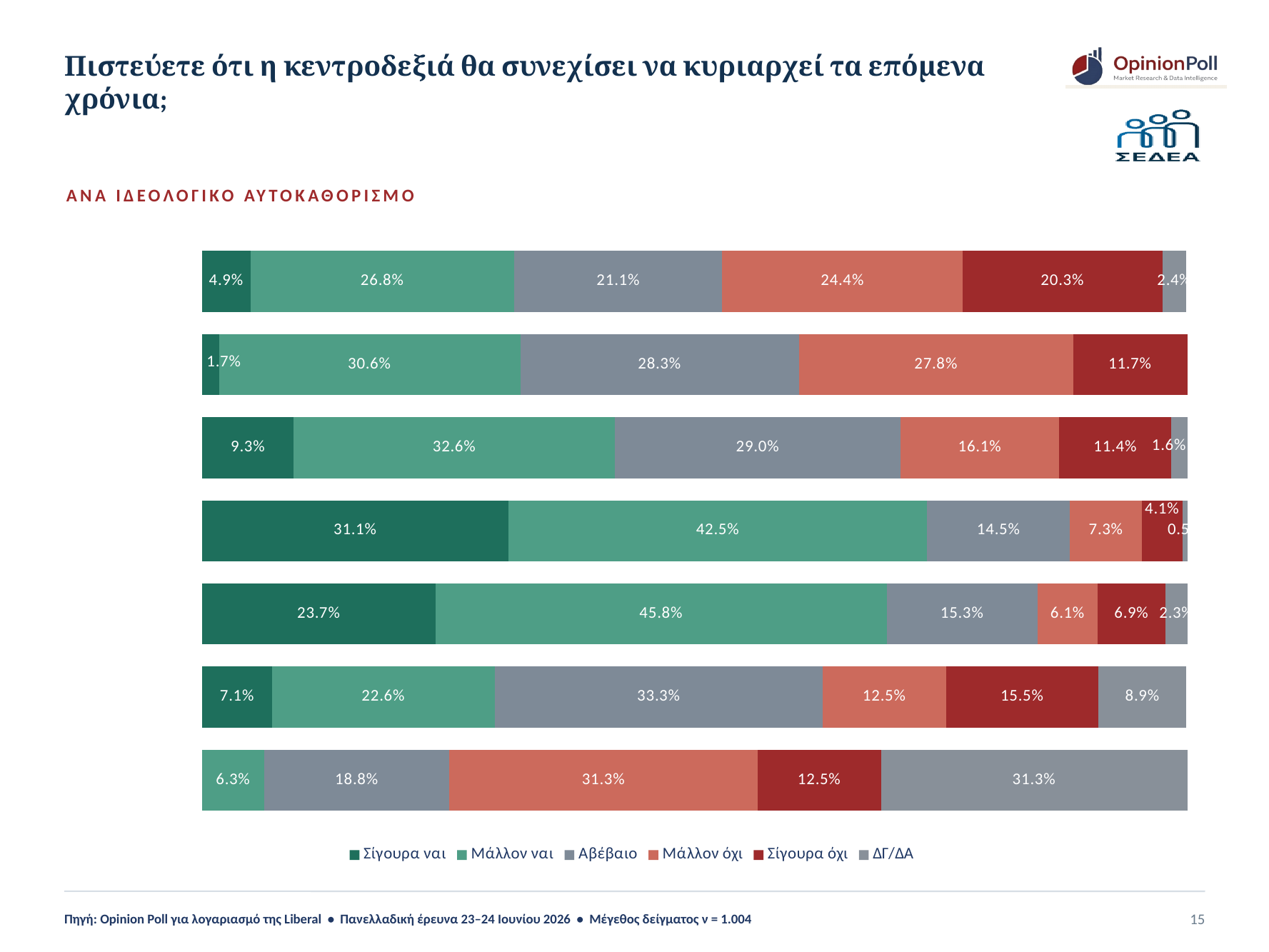
How many series does the legend list? 6 How many bars are plotted in the chart? 7 Which bar has the highest value for Μάλλον ναι? The fifth bar from the top (45.8%) In the sixth bar from the top, which is larger: Αβέβαιο or Μάλλον ναι? Αβέβαιο Which bar has the highest value for Σίγουρα ναι? The fourth bar from the top (31.1%) Which legend entry is shown in the darkest red colour? Σίγουρα όχι In the fourth bar from the top, what is the value for Σίγουρα ναι? 31.1% In the top bar, what is the difference between Μάλλον όχι and Σίγουρα όχι? 4.1 percentage points In the top bar, what is the value for Μάλλον όχι? 24.4% In the second bar from the top, what is the value for Αβέβαιο? 28.3% In the bottom bar, what is the value for ΔΓ/ΔΑ? 31.3% What kind of chart is shown on the slide? Stacked bar chart